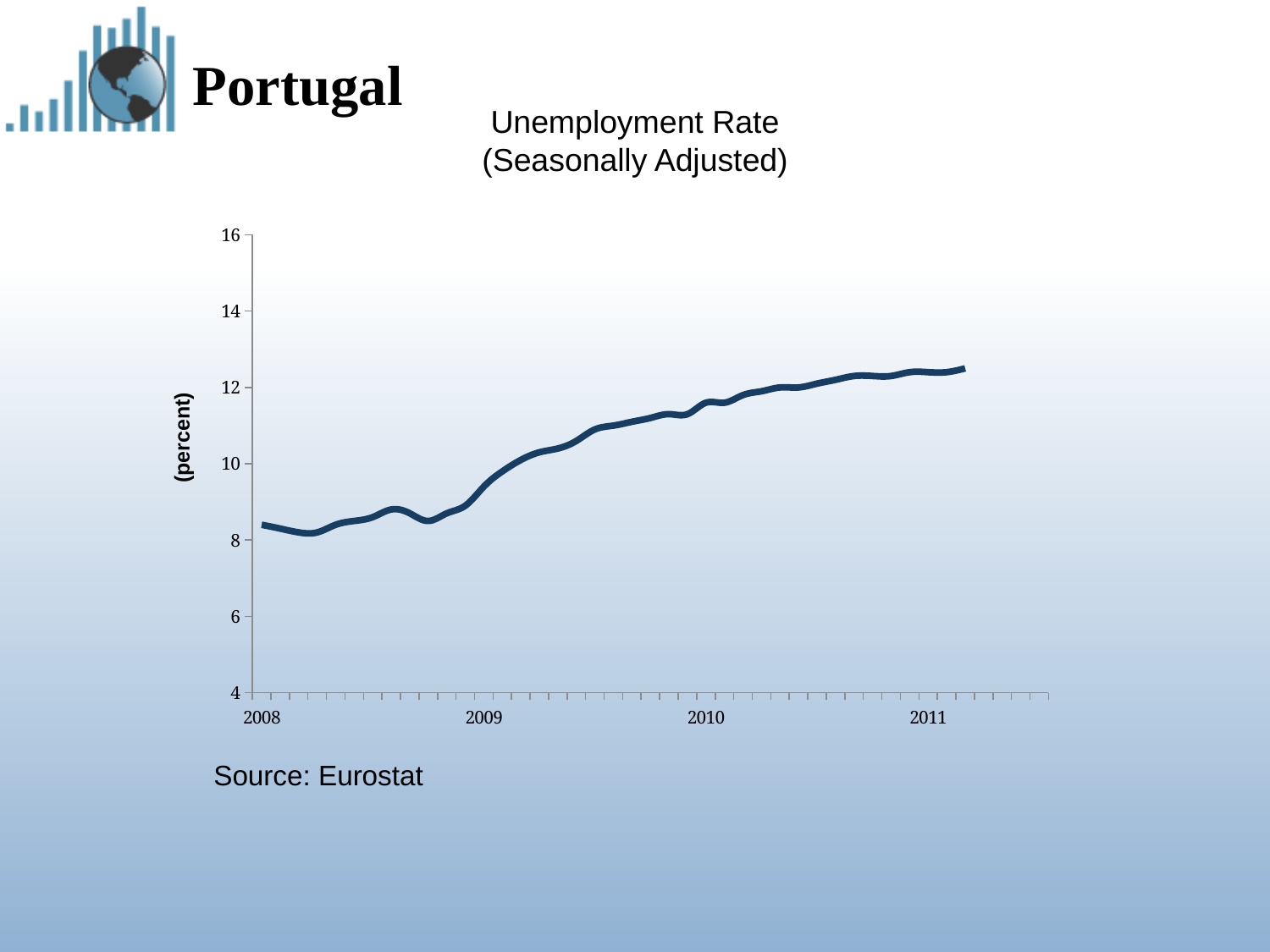
Is the unemployment rate at the start of 2011 greater or less than 12? greater What is the label on the vertical axis of the chart? (percent) Is the unemployment rate at the start of 2009 greater or less than 10? less What kind of chart is shown on the slide? line chart In which labelled year does the line reach its lowest level? 2008 Which year shown on the x axis has the highest unemployment rate at its start: 2008 or 2011? 2011 Is the unemployment rate at the start of 2010 greater or less than 10? greater What is the title of the chart? Unemployment Rate (Seasonally Adjusted) What is the highest value shown on the vertical axis? 16 Does the unemployment rate generally rise or fall from 2008 to 2011? rise